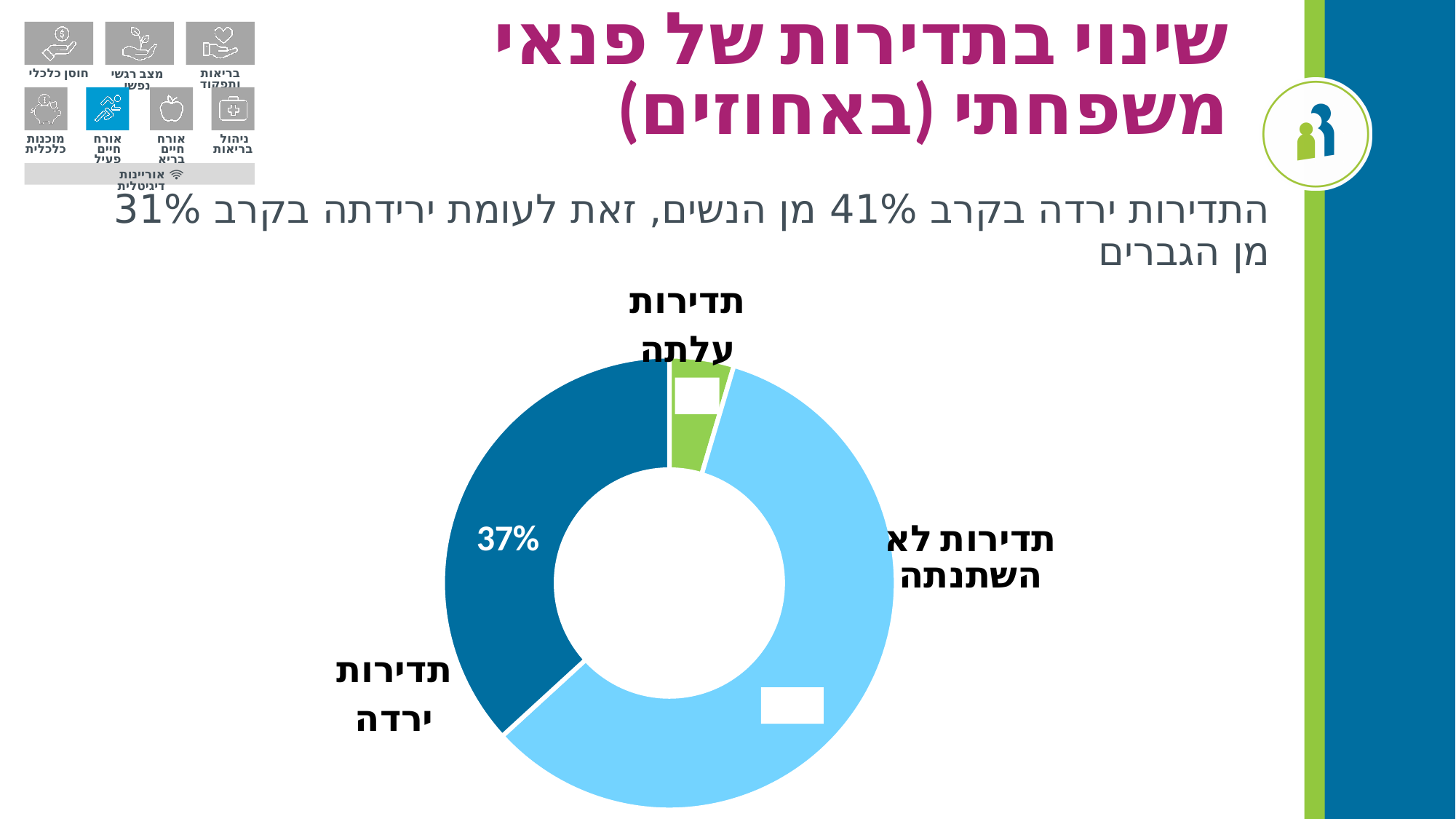
What share of the chart does 'תדירות ירדה' represent? 37% What kind of chart is shown on the slide? Pie (donut) chart Which category has the smallest slice of the chart? תדירות עלתה Which slice is larger: 'תדירות לא השתנתה' or 'תדירות ירדה'? תדירות לא השתנתה Which category has the largest slice of the chart? תדירות לא השתנתה How many categories are shown in the chart? 3 What percentage is shown for the 'תדירות ירדה' slice? 37% What is the title of the slide? שינוי בתדירות של פנאי משפחתי (באחוזים) What colour is the 'תדירות עלתה' slice? Green Which slice is larger: 'תדירות ירדה' or 'תדירות עלתה'? תדירות ירדה